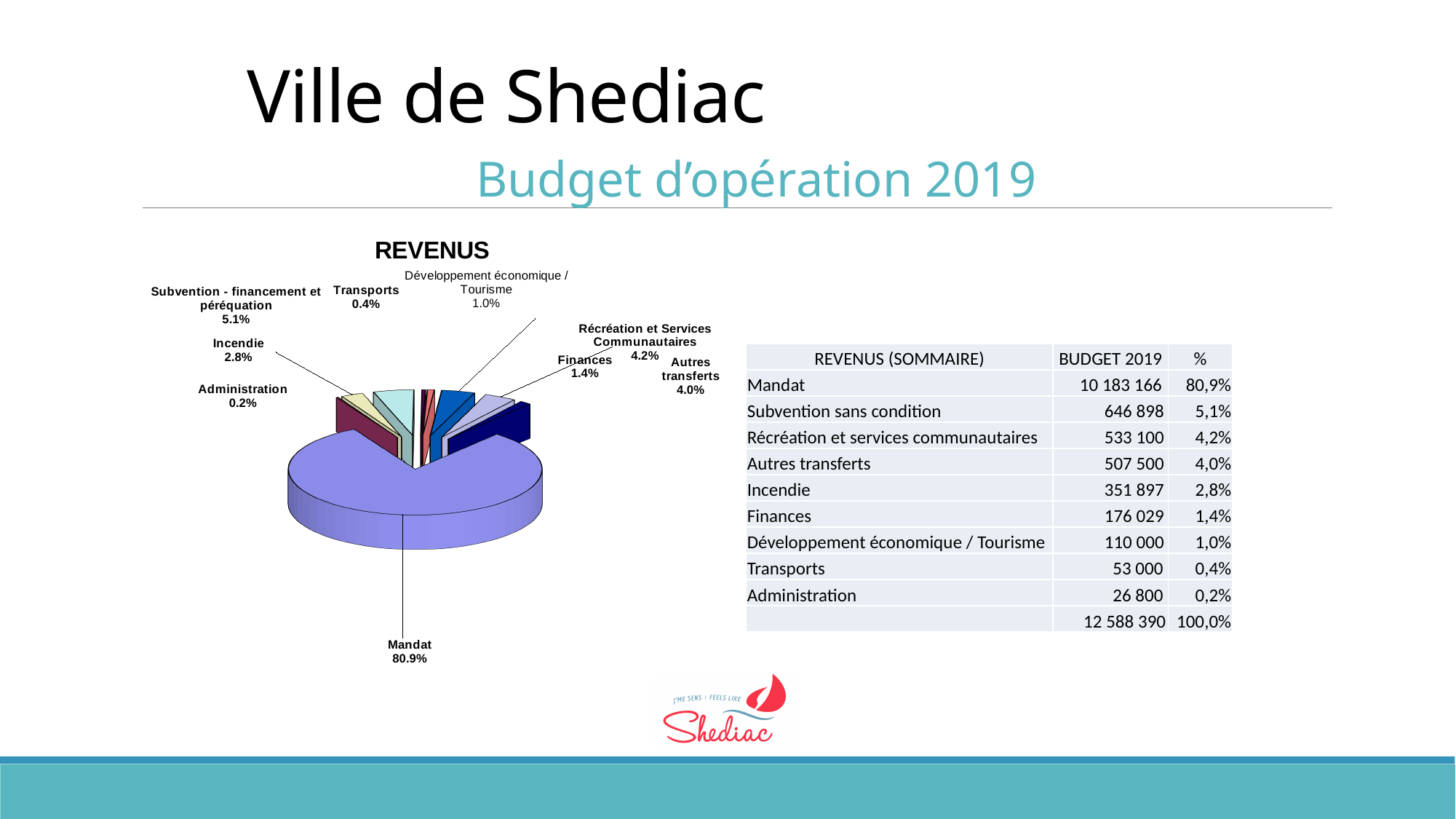
Which slice of the REVENUS pie chart is the largest? Mandat What is the title of the chart on the slide? REVENUS How many slices does the REVENUS pie chart have? 9 Which slice of the REVENUS pie chart is the smallest? Administration What percentage is shown for Incendie in the REVENUS pie chart? 2.8% What percentage is shown for Développement économique / Tourisme in the REVENUS pie chart? 1.0% In the REVENUS pie chart, what is the difference in percentage points between Mandat and Subvention - financement et péréquation? 75.8% In the REVENUS pie chart, what is the difference in percentage points between Finances and Transports? 1.0% What percentage is shown for Récréation et Services Communautaires in the REVENUS pie chart? 4.2% In the REVENUS pie chart, which is larger: Subvention - financement et péréquation or Autres transferts? Subvention - financement et péréquation What kind of chart is the REVENUS chart? pie chart What share of the REVENUS pie does Mandat represent? 80.9%